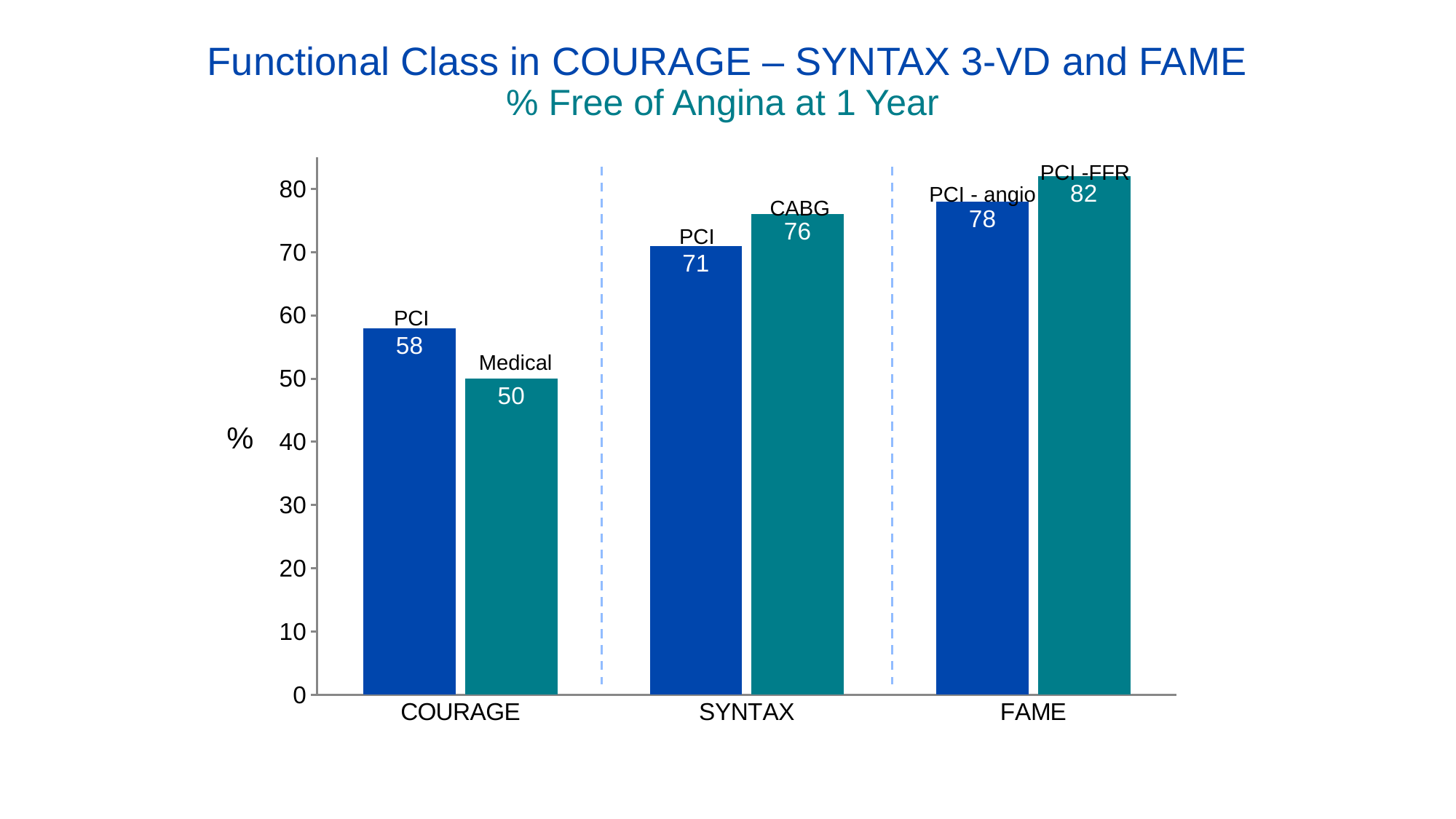
What is the value for CABG in the SYNTAX trial? 76 Which bar has the highest value on the chart? PCI-FFR (FAME) What is the value for PCI-FFR in the FAME trial? 82 What is the subtitle of the chart? % Free of Angina at 1 Year What is the difference between CABG and PCI in the SYNTAX trial? 5 Which is larger in the FAME trial, PCI-angio or PCI-FFR? PCI-FFR What kind of chart is shown on the slide? Bar chart What is the value for PCI in the COURAGE trial? 58 What is the difference between PCI and Medical in the COURAGE trial? 8 How many trials are shown along the x axis? 3 What is the value for Medical in the COURAGE trial? 50 Which bar has the lowest value on the chart? Medical (COURAGE)